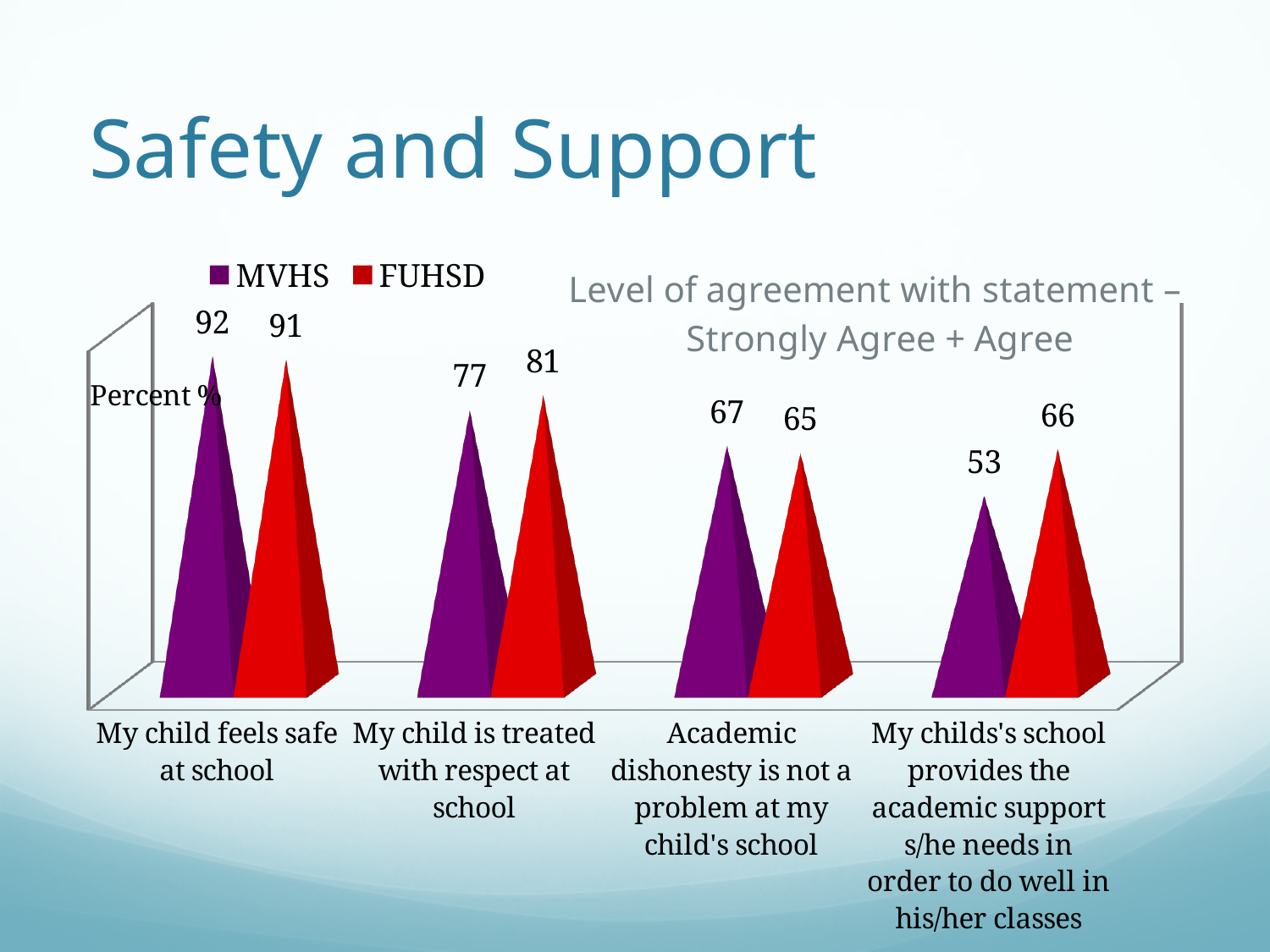
What is the FUHSD value for "My child is treated with respect at school"? 81 Which statement has the lowest FUHSD value? Academic dishonesty is not a problem at my child's school Which statement has the highest MVHS value? My child feels safe at school How many statements (categories) are shown on the x axis? 4 What is the MVHS value for "My childs's school provides the academic support s/he needs in order to do well in his/her classes"? 53 What kind of chart is shown on the slide? Bar chart What is the MVHS value for "My child feels safe at school"? 92 What is the difference between the FUHSD and MVHS values for "My childs's school provides the academic support s/he needs in order to do well in his/her classes"? 13 What is the title of the chart? Level of agreement with statement – Strongly Agree + Agree For "My child is treated with respect at school", which is larger, the MVHS value or the FUHSD value? FUHSD How many series does the legend list? 2 What is the FUHSD value for "Academic dishonesty is not a problem at my child's school"? 65